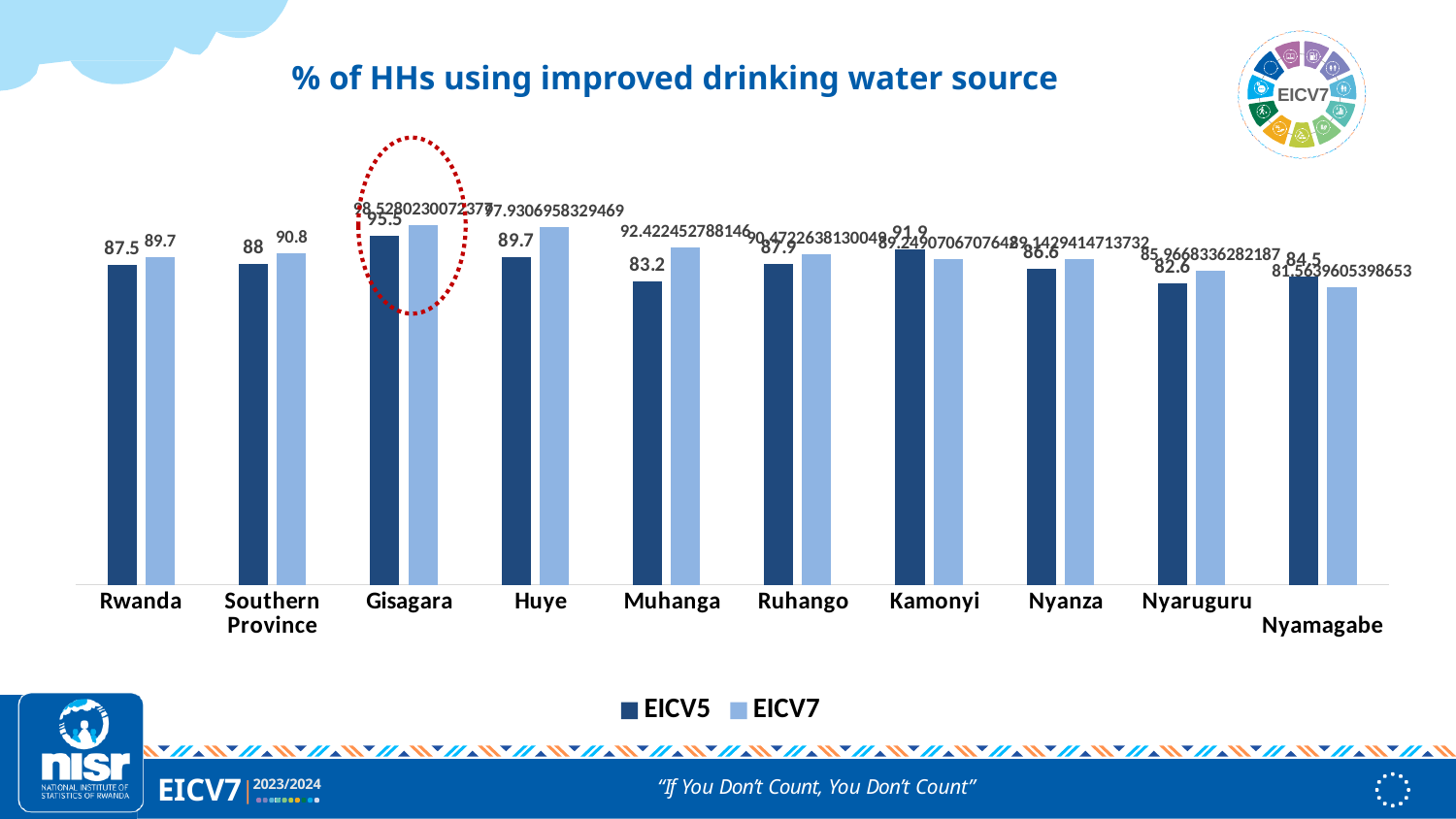
What kind of chart is shown on the slide? Bar chart What is the EICV5 value for Rwanda? 87.5 Which category has the highest EICV5 value? Gisagara What is the difference between the EICV7 and EICV5 values for Rwanda? 2.2 Which category has the lowest EICV5 value? Nyaruguru How many series does the legend list? 2 What is the difference between the EICV7 and EICV5 values for Southern Province? 2.8 What is the EICV7 value for Southern Province? 90.8 What is the EICV5 value for Muhanga? 83.2 How many categories are shown on the x axis? 10 For Kamonyi, which series has the larger value, EICV5 or EICV7? EICV5 What is the EICV5 value for Nyamagabe? 84.5